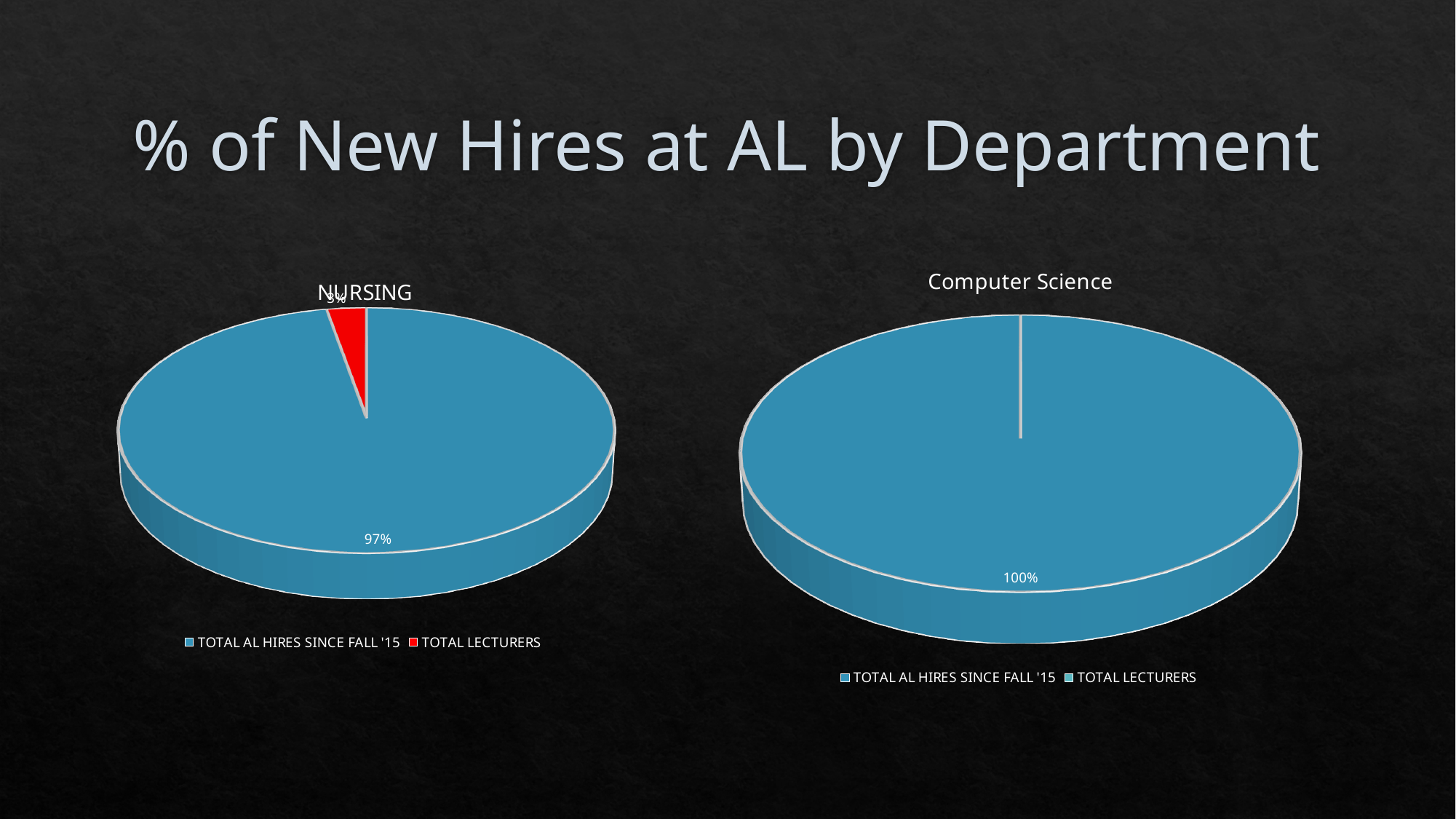
In the NURSING chart, which is larger: TOTAL AL HIRES SINCE FALL '15 or TOTAL LECTURERS? TOTAL AL HIRES SINCE FALL '15 What is the title of the chart on the right of the slide? Computer Science How many series does the legend of the NURSING chart list? 2 In the NURSING chart, which slice is the smallest? TOTAL LECTURERS What kind of chart is the NURSING chart? pie chart In the NURSING chart, which slice is the largest? TOTAL AL HIRES SINCE FALL '15 In the NURSING chart, what colour is the TOTAL LECTURERS slice? red In the NURSING chart, what share of the pie is TOTAL AL HIRES SINCE FALL '15? 97% How many pie charts are shown on the slide? 2 How many series does the legend of the Computer Science chart list? 2 In the Computer Science chart, what share of the pie is TOTAL AL HIRES SINCE FALL '15? 100%